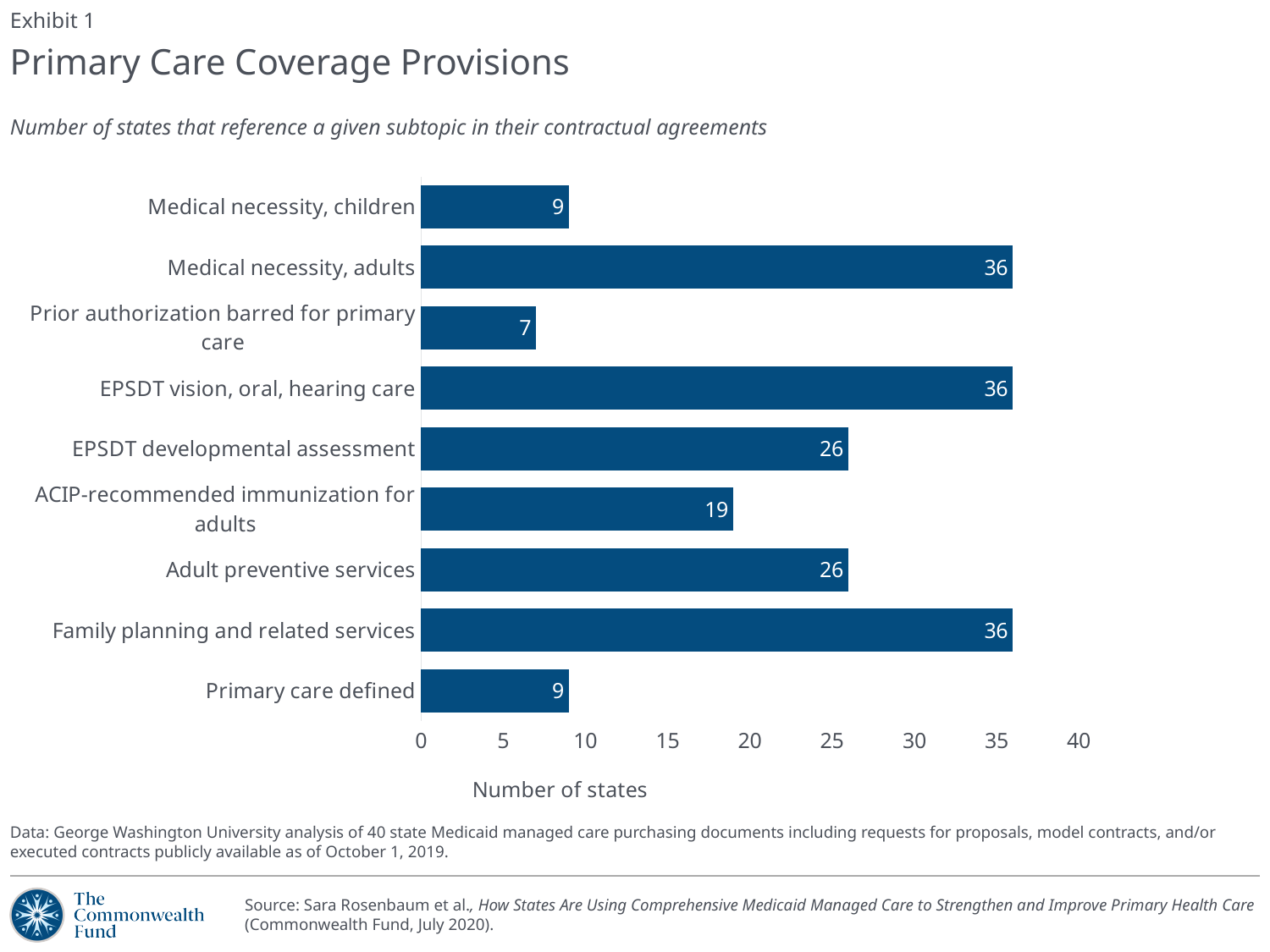
What is the number of states for Medical necessity, adults? 36 What kind of chart is shown on the slide? Bar chart Which has more states referencing it: EPSDT developmental assessment or ACIP-recommended immunization for adults? EPSDT developmental assessment How many subtopics are shown in the chart? 9 What is the number of states for EPSDT developmental assessment? 26 What is the difference in number of states between Family planning and related services and Adult preventive services? 10 Is the value for Primary care defined greater or less than 10? less Which subtopic has the lowest number of states? Prior authorization barred for primary care What is the label of the horizontal axis? Number of states What is the number of states for Prior authorization barred for primary care? 7 What is the difference in number of states between Medical necessity, adults and Medical necessity, children? 27 What is the number of states for ACIP-recommended immunization for adults? 19